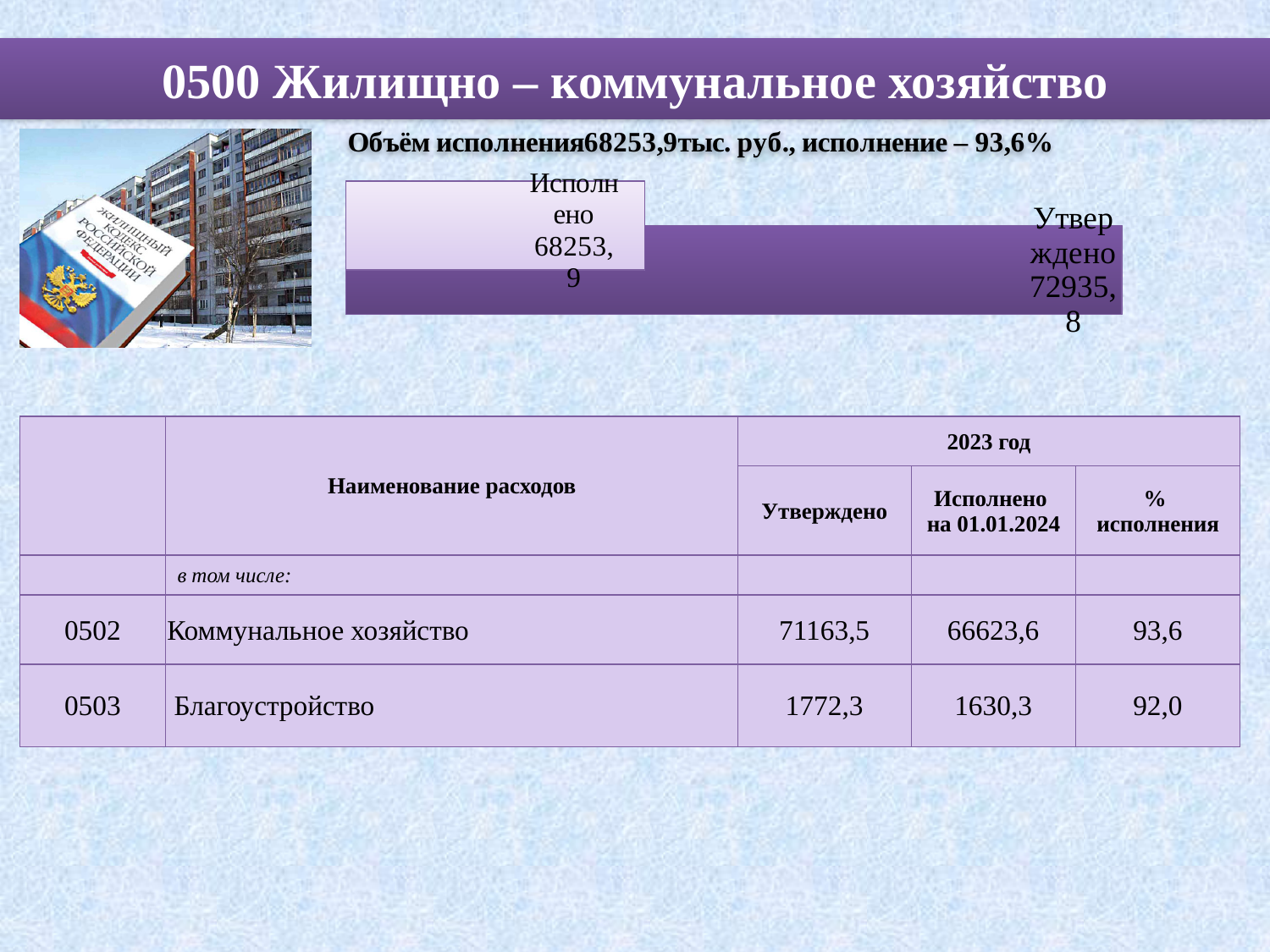
What is the difference between the Утверждено and Исполнено values? 4681,9 What is the value of the bar labelled Исполнено? 68253,9 Which bar is drawn in the darker purple colour? Утверждено What is the value of the bar labelled Утверждено? 72935,8 What type of chart is shown on the slide? bar chart How many bars are plotted in the chart? 2 Are the bars in the chart horizontal or vertical? horizontal Which bar has the lowest value? Исполнено Which bar has the highest value? Утверждено Which is larger, Утверждено or Исполнено? Утверждено